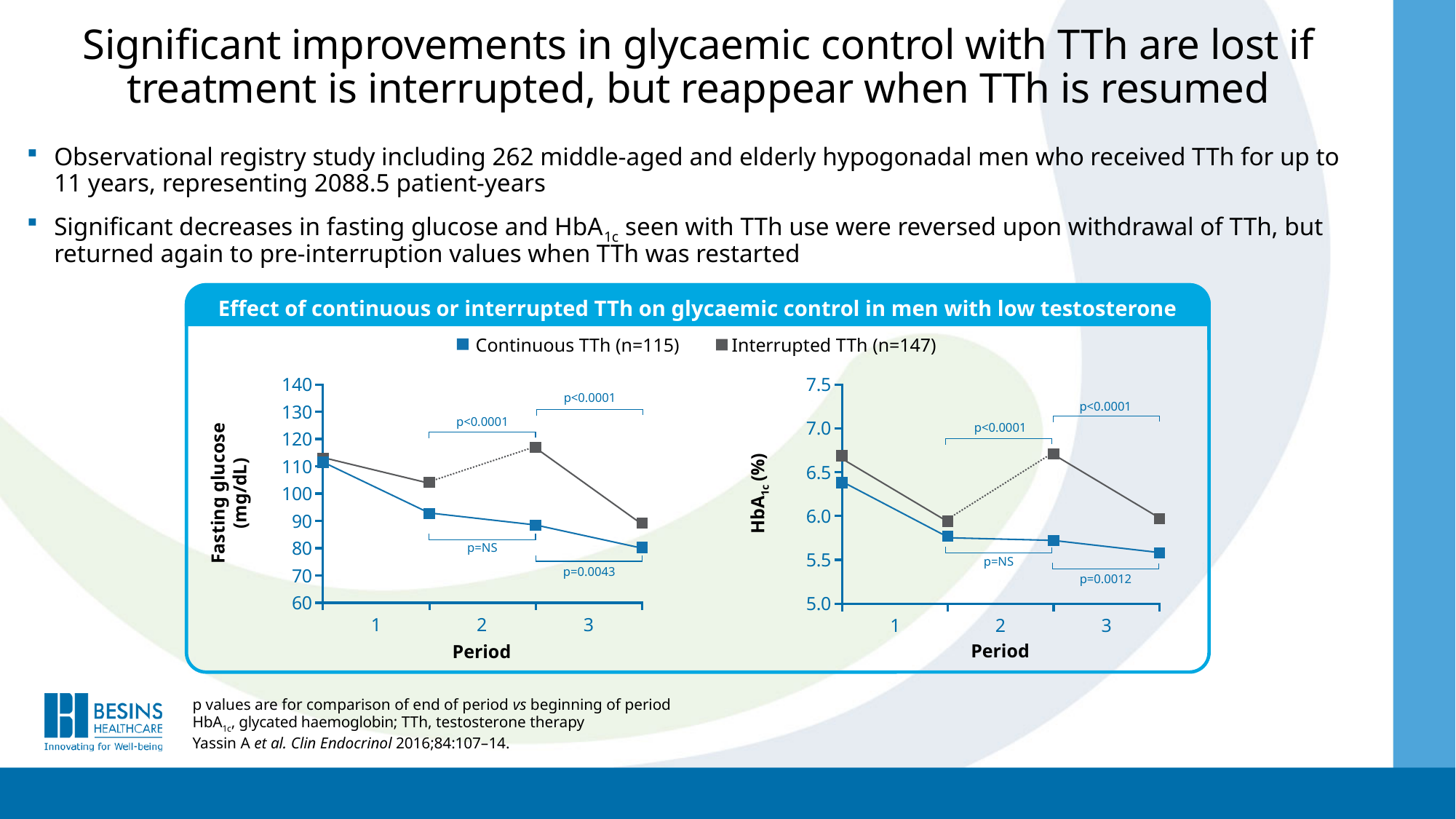
In the HbA1c chart, what p value is shown for the Continuous TTh series in period 3? p=0.0012 In the fasting glucose chart, does the Continuous TTh series rise or fall across the periods? Fall In the HbA1c chart, is the Continuous TTh value at the end of period 3 greater or less than 6.0? less In the HbA1c chart, is the Interrupted TTh value at the end of period 2 greater or less than 6.5? greater In the fasting glucose chart, is the Interrupted TTh value at the end of period 2 greater or less than 110? greater In the HbA1c chart, which series has the higher value at the end of period 3, Continuous TTh or Interrupted TTh? Interrupted TTh How many periods are shown on the x axis of the HbA1c chart? 3 What is the sample size shown in the legend for the Interrupted TTh group? n=147 How many series does the legend list for the charts? 2 In the fasting glucose chart, how many data points are plotted for the Continuous TTh series? 4 What kind of chart is the fasting glucose chart on the left? Line chart